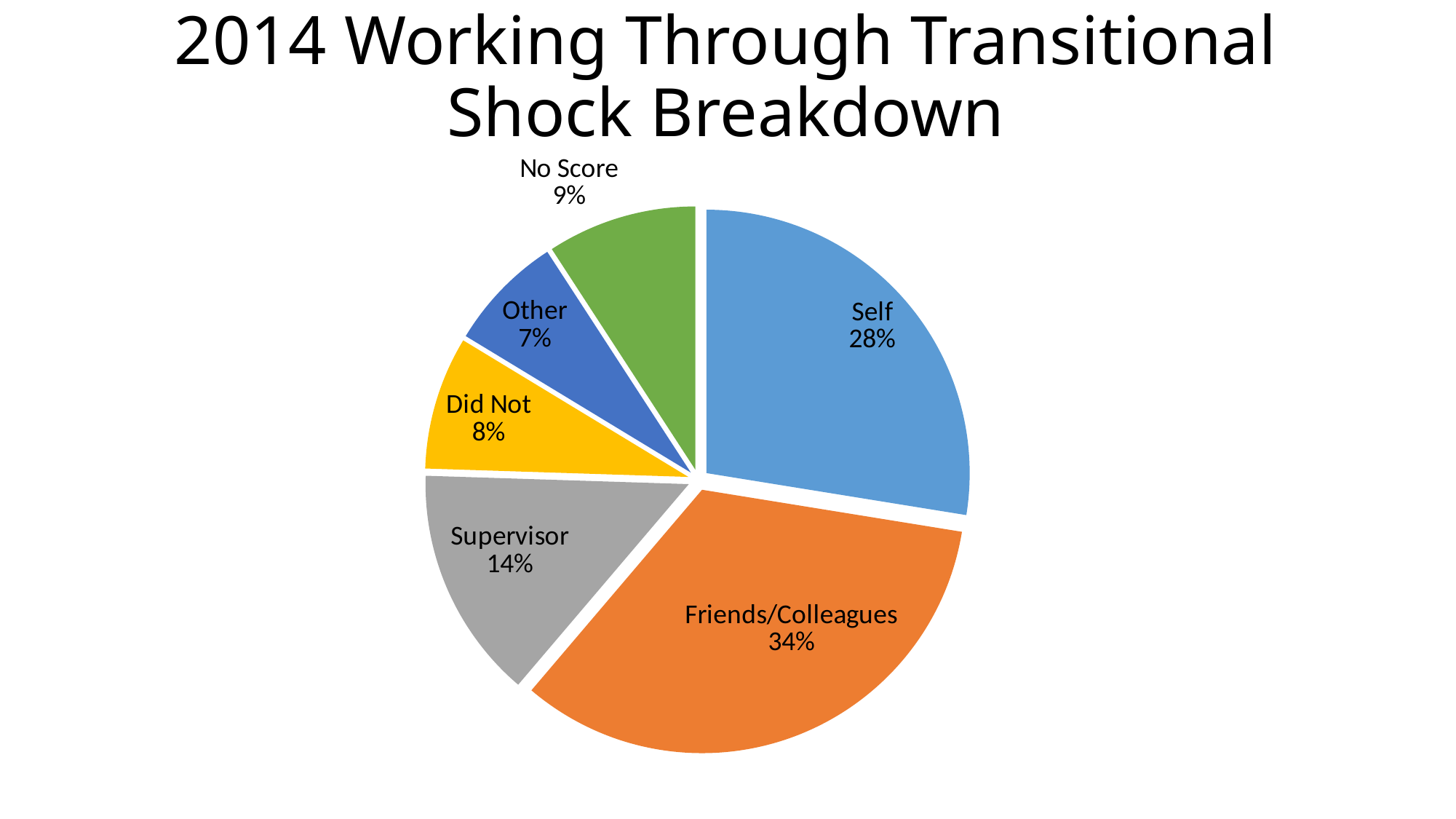
What kind of chart is shown on the slide? pie chart Which category has the largest slice? Friends/Colleagues How many slices does the pie chart have? 6 What share of the pie is Self? 28% What share of the pie is No Score? 9% What share of the pie is Supervisor? 14% What is the difference between the Friends/Colleagues share and the Self share? 6% Which is larger, the Did Not slice or the Supervisor slice? Supervisor What is the title of the chart? 2014 Working Through Transitional Shock Breakdown Which category has the smallest slice? Other